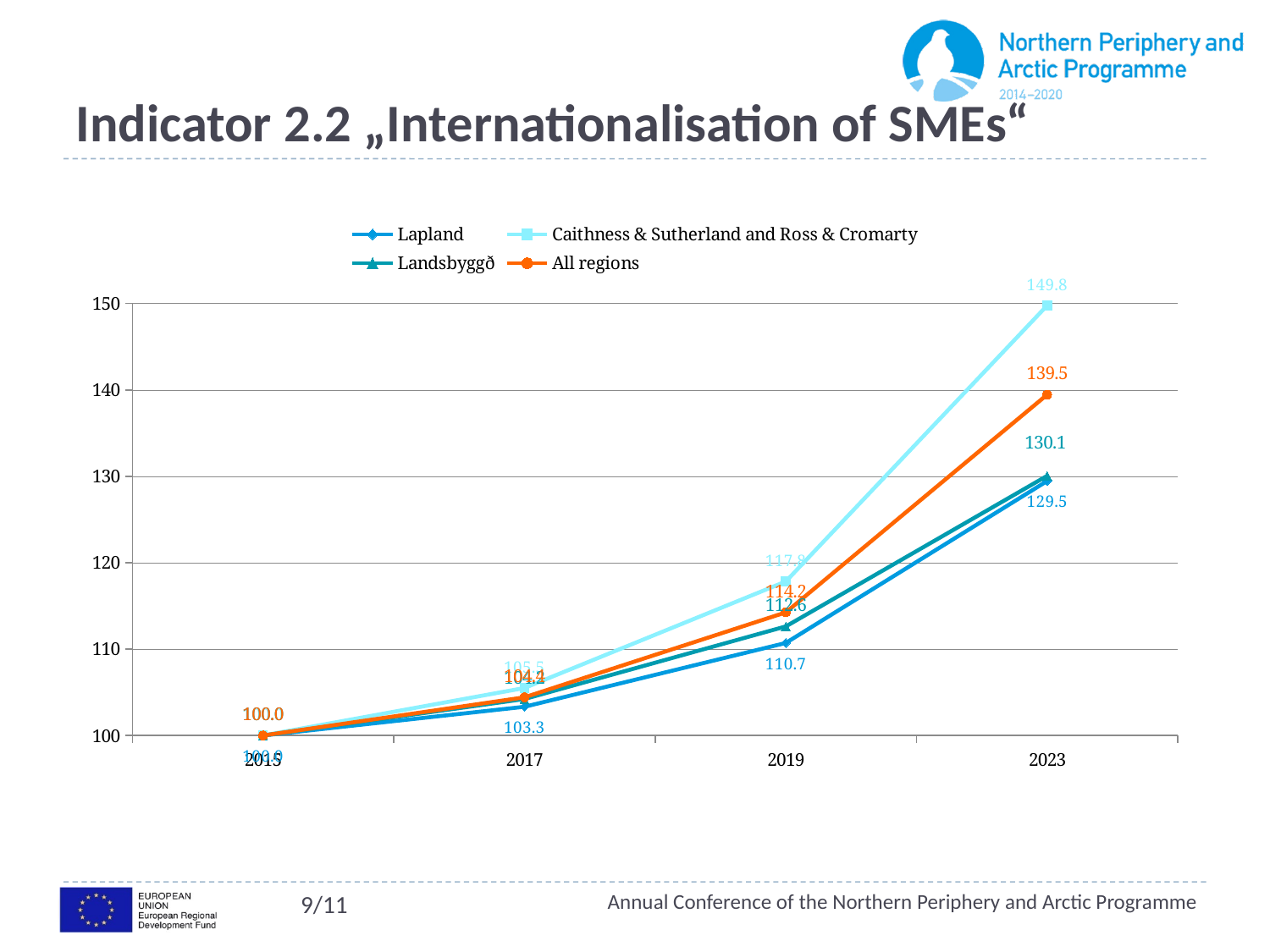
Which series has the highest value in 2023? Caithness & Sutherland and Ross & Cromarty What kind of chart is shown on the slide? line chart What is the difference between the Caithness & Sutherland and Ross & Cromarty value and the All regions value in 2023? 10.3 What is the value for Lapland in 2017? 103.3 Which series has the lowest value in 2019? Lapland Is the value for All regions in 2019 greater or less than 120? less What is the value for Lapland in 2019? 110.7 How many series does the legend list? 4 How many years are plotted along the x axis? 4 What is the value for All regions in 2023? 139.5 Does the Lapland series rise or fall from 2015 to 2023? rise What is the value for Caithness & Sutherland and Ross & Cromarty in 2023? 149.8